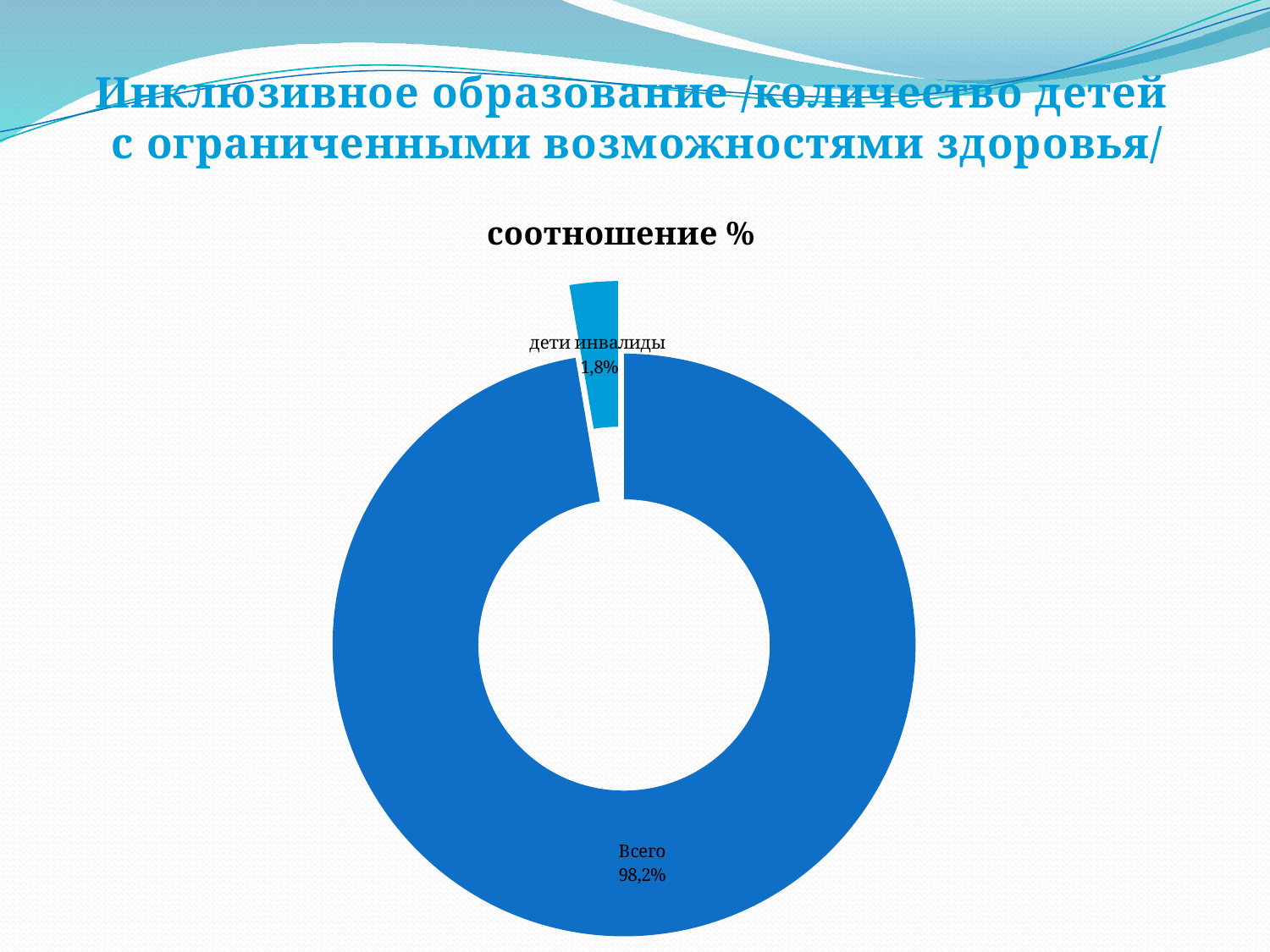
Which is larger, the "Всего" slice or the "дети инвалиды" slice? Всего What is the value shown for the "дети инвалиды" slice? 1,8% What share of the chart does the "дети инвалиды" slice represent? 1,8% What is the value shown for the "Всего" slice? 98,2% How many slices does the chart have? 2 What kind of chart is shown on the slide? Doughnut chart Which slice is the largest? Всего Which slice is the smallest? дети инвалиды What is the title of the chart? соотношение % What is the difference between the "Всего" and "дети инвалиды" values? 96,4%